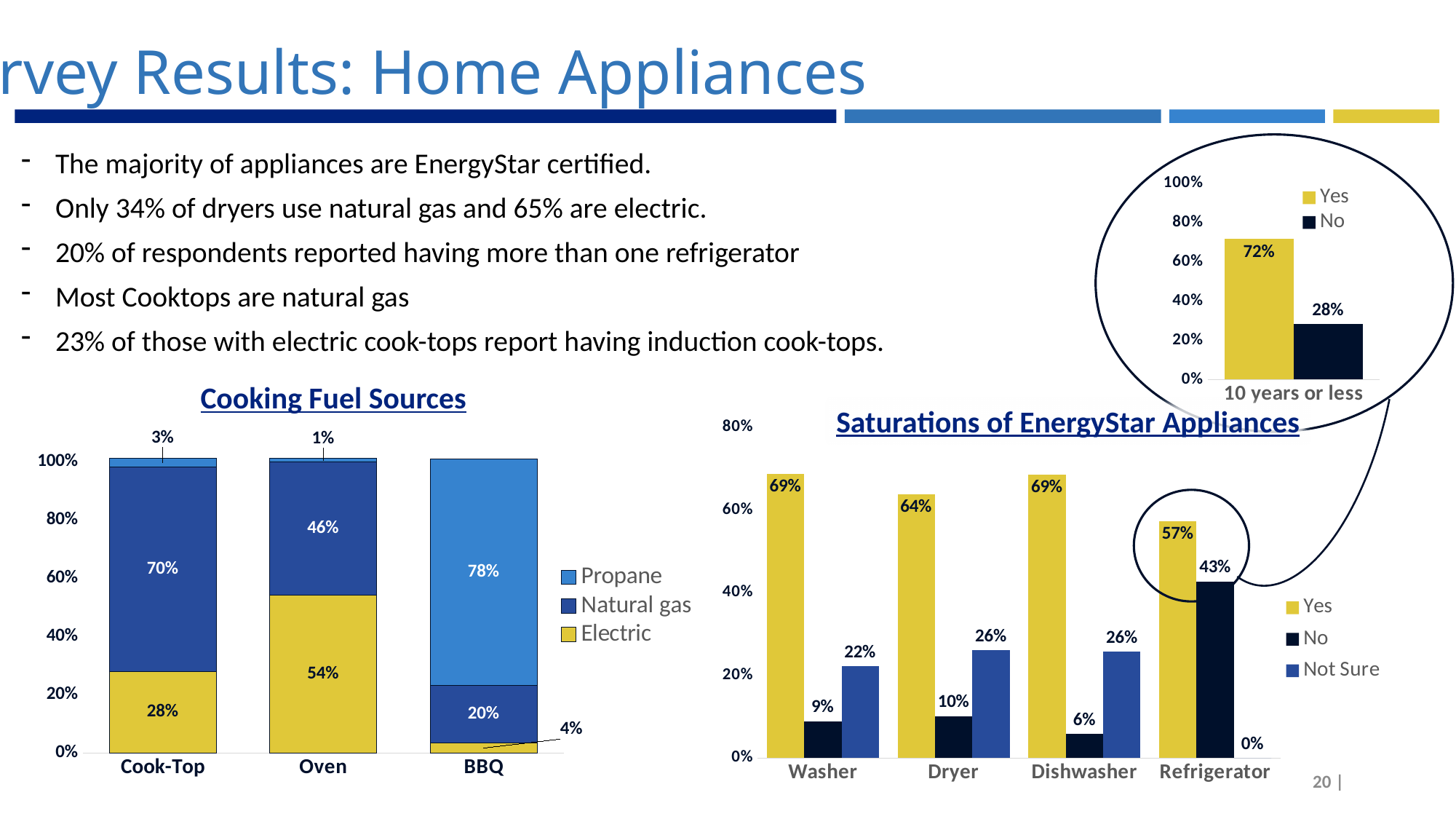
In the Saturations of EnergyStar Appliances chart, how many appliance categories are shown on the x axis? 4 In the Saturations of EnergyStar Appliances chart, which appliance has the highest No value? Refrigerator In the Cooking Fuel Sources chart, how many series does the legend list? 3 In the Cooking Fuel Sources chart, what percentage of cook-tops use natural gas? 70% What kind of chart is the Cooking Fuel Sources chart? Stacked bar chart In the Saturations of EnergyStar Appliances chart, what is the Yes value for Dryer? 64% In the small inset chart labelled '10 years or less' at the top right, what is the Yes value? 72% In the Cooking Fuel Sources chart, what is the difference between the Natural gas shares for Cook-Top and Oven? 24% In the Saturations of EnergyStar Appliances chart, which appliance has the lowest Yes value? Refrigerator In the Cooking Fuel Sources chart, which category has the highest Propane share? BBQ In the Saturations of EnergyStar Appliances chart, is the Yes value for Washer or for Refrigerator larger? Washer In the Cooking Fuel Sources chart, what is the Electric share for Oven? 54%